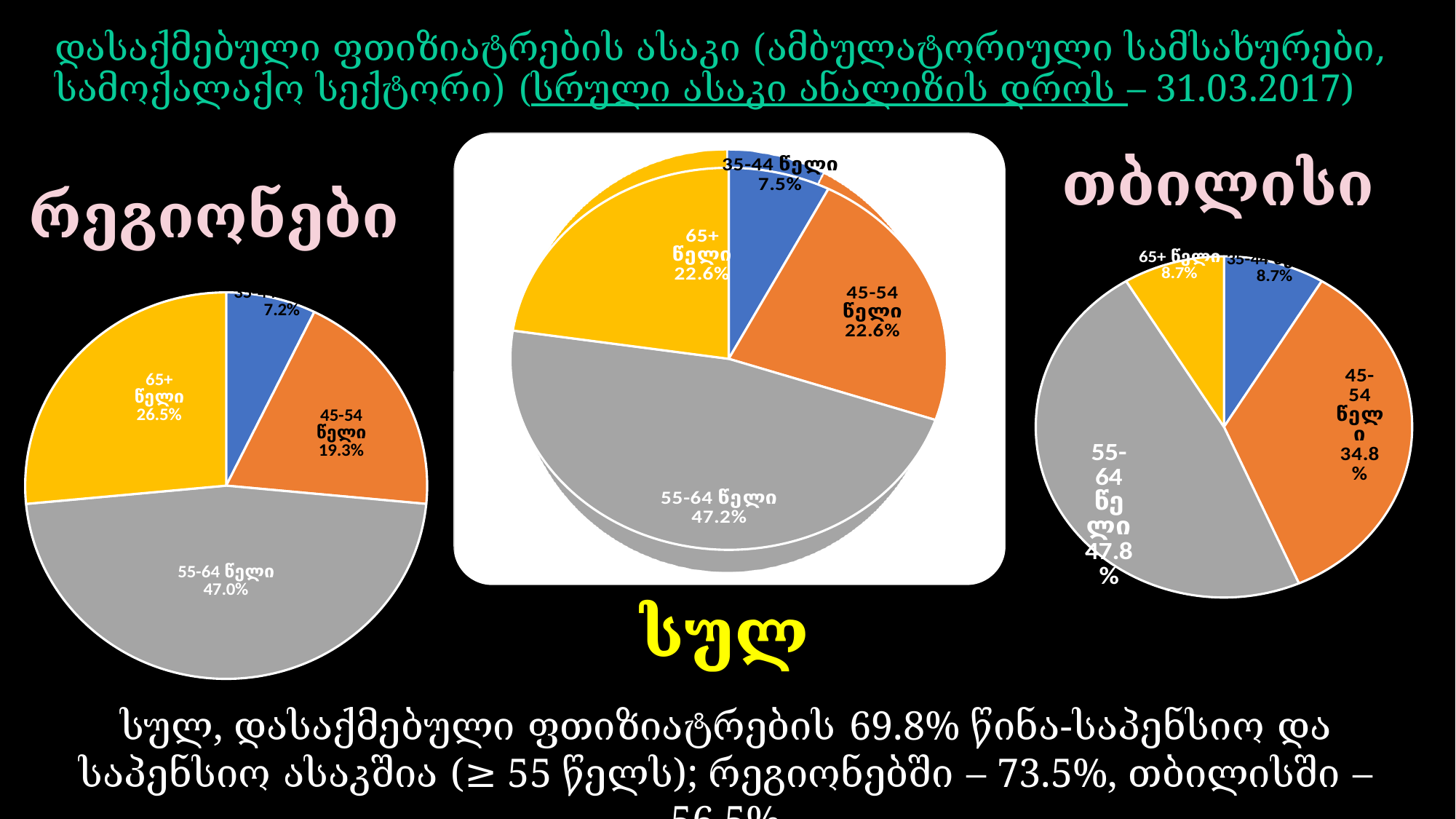
In the სულ (Total) pie chart, what share is shown for the 35-44 წელი slice? 7.5% In the სულ (Total) pie chart, which is larger: the 55-64 წელი share or the 65+ წელი share? 55-64 წელი What type of chart is used for the თბილისი (Tbilisi) data? Pie chart In the სულ (Total) pie chart, what share is shown for the 45-54 წელი slice? 22.6% In the თბილისი (Tbilisi) pie chart, what share is shown for the 55-64 წელი slice? 47.8% In the თბილისი (Tbilisi) pie chart, what share is shown for the 45-54 წელი slice? 34.8% How many slices does the სულ (Total) pie chart have? 4 In the რეგიონები (Regions) pie chart, which age group has the largest share? 55-64 წელი In the რეგიონები (Regions) pie chart, which age group has the smallest share? 35-44 წელი In the თბილისი (Tbilisi) pie chart, what is the difference between the 55-64 წელი share and the 45-54 წელი share? 13.0% In the რეგიონები (Regions) pie chart, what share is shown for the 65+ წელი slice? 26.5% In the რეგიონები (Regions) pie chart, what share is shown for the 55-64 წელი slice? 47.0%